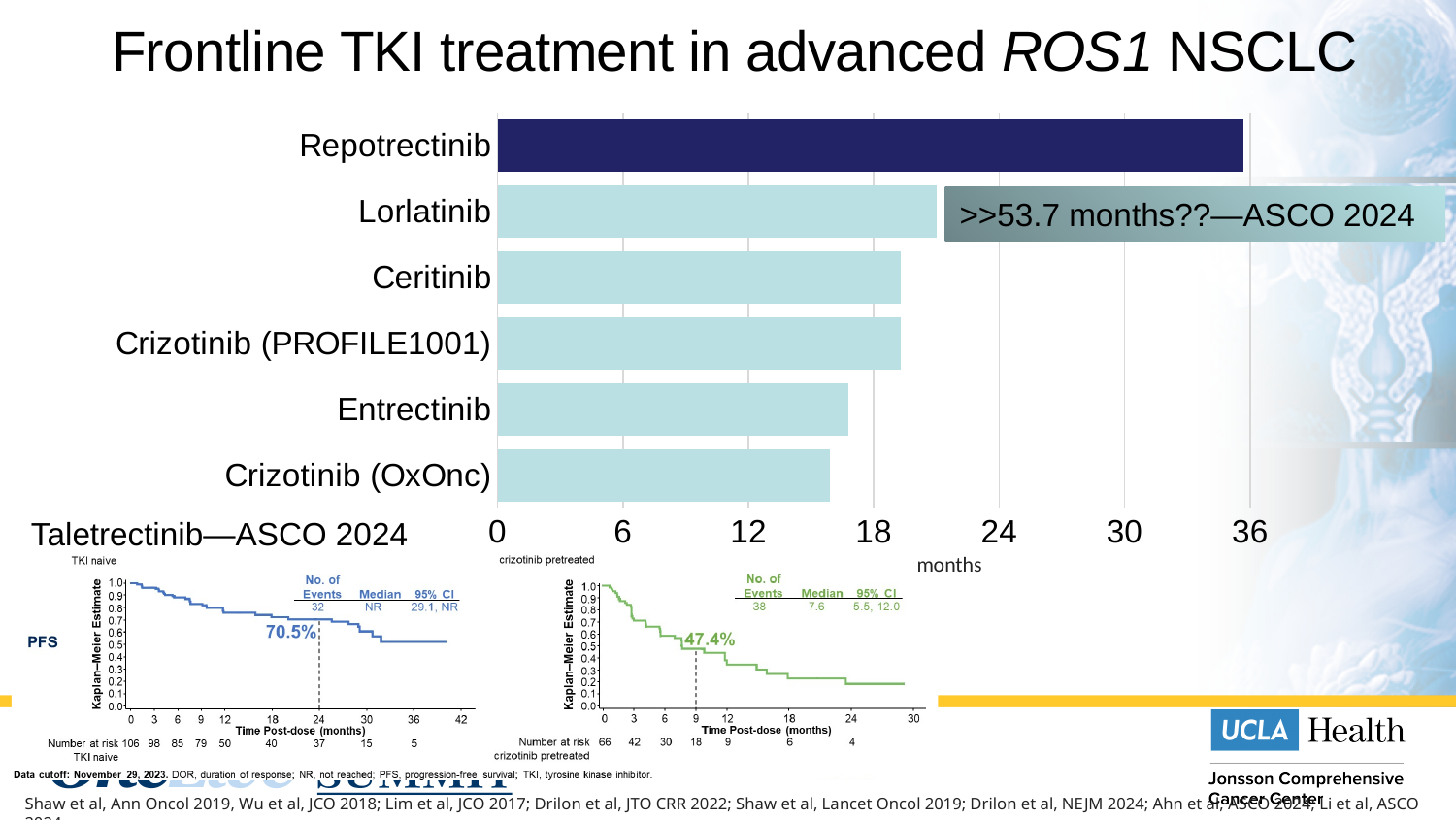
In the bar chart, is the value for Repotrectinib greater or less than 30 months? greater In the bar chart, is the value for Lorlatinib greater or less than 18 months? greater How many TKI treatment categories are shown in the bar chart? 6 In the bar chart, is the value for Entrectinib greater or less than 18 months? less In the Taletrectinib crizotinib pretreated Kaplan-Meier plot, what is the median PFS shown? 7.6 What unit is shown on the x axis of the bar chart? months What kind of chart is the main chart on the slide comparing TKI treatments? bar chart In the bar chart, which has the larger value, Lorlatinib or Entrectinib? Lorlatinib In the bar chart, which treatment has the longest bar? Repotrectinib In the Taletrectinib TKI naive Kaplan-Meier plot, what is the number of events shown? 32